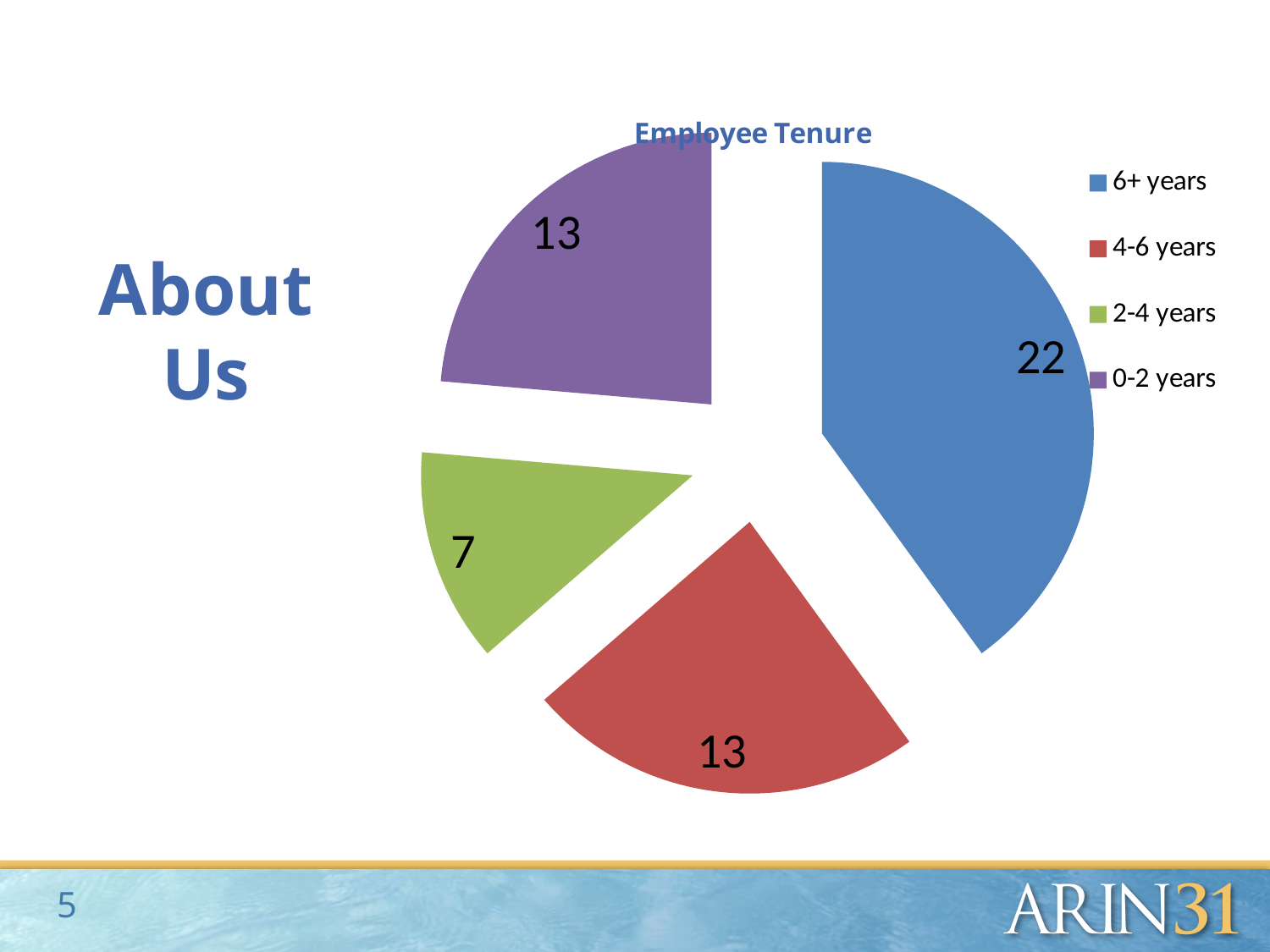
What is the difference between the 6+ years value and the 4-6 years value in the Employee Tenure chart? 9 Which tenure category has the largest slice in the Employee Tenure pie chart? 6+ years What is the title of the chart on the slide? Employee Tenure What is the value for the 4-6 years slice in the Employee Tenure pie chart? 13 What is the value for the 2-4 years slice in the Employee Tenure pie chart? 7 What is the value for the 6+ years slice in the Employee Tenure pie chart? 22 How many categories are shown in the Employee Tenure pie chart? 4 What type of chart is used to show Employee Tenure? Pie chart What share of the total does the 6+ years slice represent in the Employee Tenure pie chart? 40% What is the difference between the 0-2 years value and the 2-4 years value in the Employee Tenure chart? 6 Which tenure category has the smallest slice in the Employee Tenure pie chart? 2-4 years Which is larger in the Employee Tenure chart, the 6+ years slice or the 0-2 years slice? 6+ years